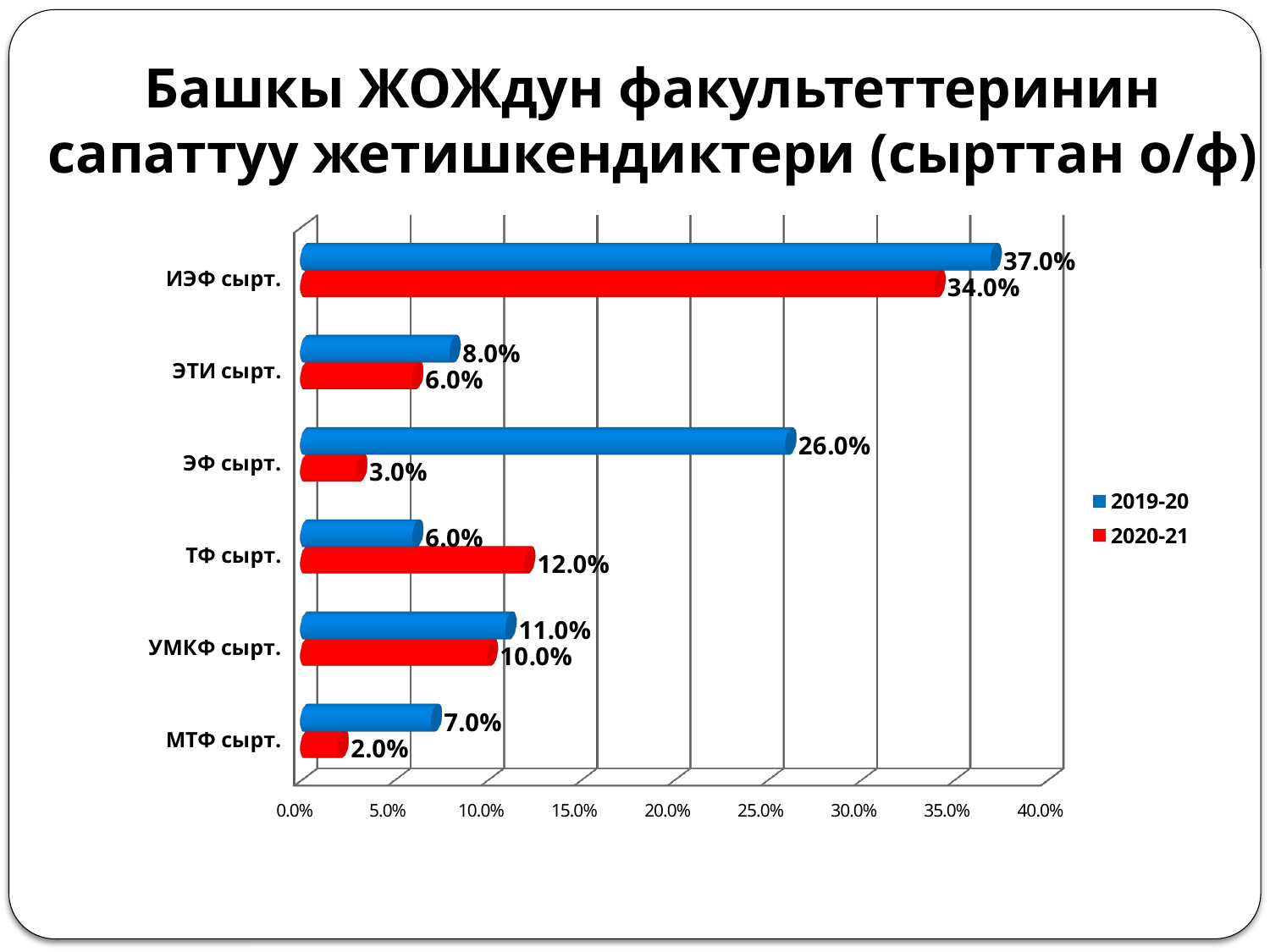
What kind of chart is shown on the slide? bar chart Which category has the highest 2019-20 value? ИЭФ сырт. Which category has the lowest 2020-21 value? МТФ сырт. What is the difference between the 2019-20 and 2020-21 values for ЭФ сырт.? 23.0% How many series does the legend list? 2 Which is larger for ТФ сырт., the 2019-20 value or the 2020-21 value? 2020-21 What is the 2019-20 value for ИЭФ сырт.? 37.0% What is the 2020-21 value for ЭФ сырт.? 3.0% How many categories are shown on the chart? 6 What is the difference between the 2019-20 values for ИЭФ сырт. and УМКФ сырт.? 26.0% What is the 2020-21 value for ТФ сырт.? 12.0% Is the 2020-21 value for ИЭФ сырт. greater or less than 30.0%? greater